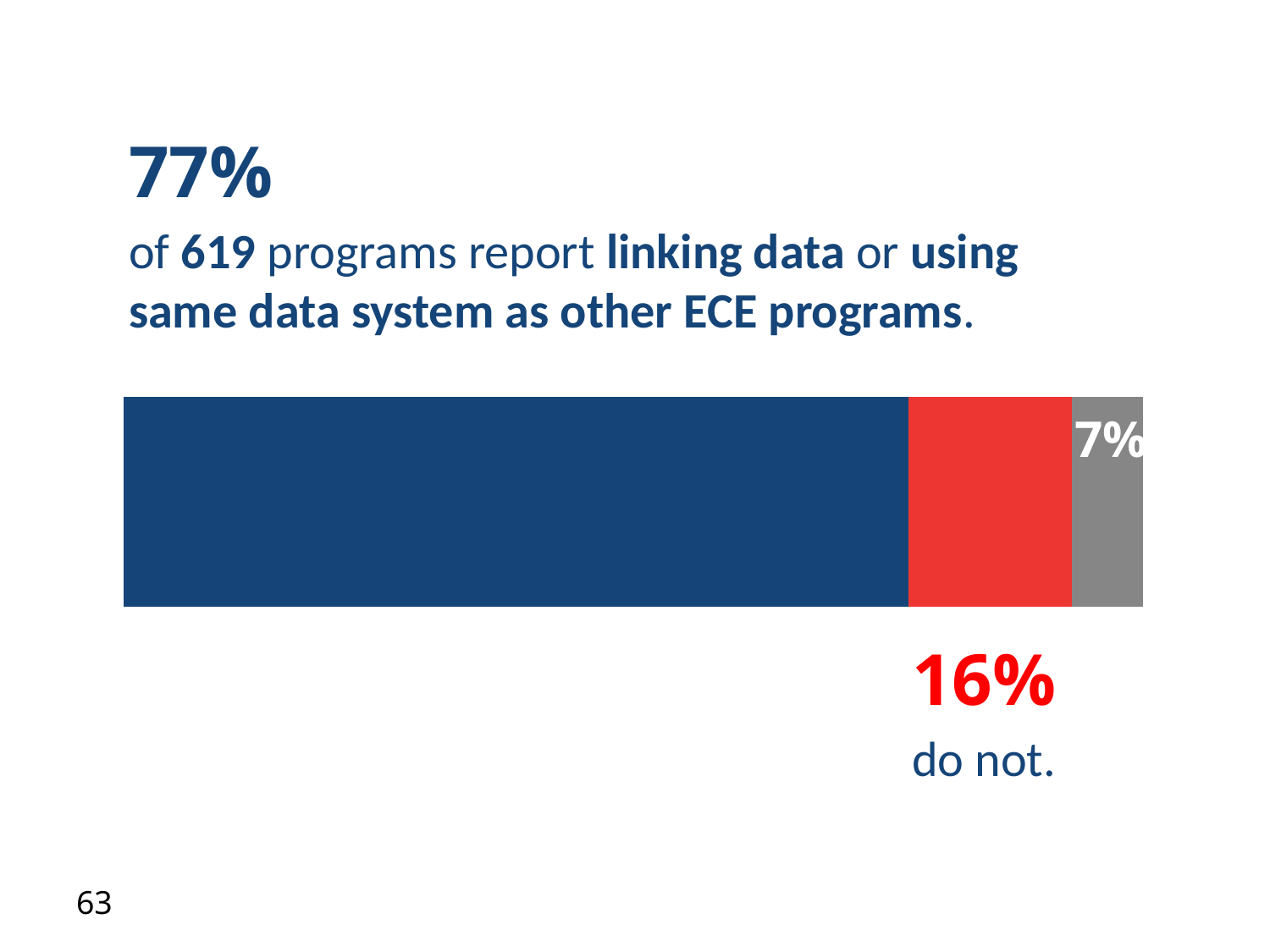
What is the difference between the share of programs that link data (77%) and the share that do not (16%)? 61% Which segment of the bar is the smallest? The gray segment (7%) What is the difference between the red segment (16%) and the gray segment (7%)? 9% What kind of chart is shown on the slide? A stacked bar chart Which segment of the bar is the largest? The blue segment (77%) What percentage of programs do not link data or use the same data system as other ECE programs? 16% What is the total of the three segments in the bar (77%, 16% and 7%)? 100% Which is larger, the red segment or the gray segment? The red segment What colour is the segment representing the 16% of programs that do not link data? Red What value is printed on the gray segment of the bar? 7% How many segments make up the stacked bar? 3 What percentage of the 619 programs report linking data or using the same data system as other ECE programs? 77%